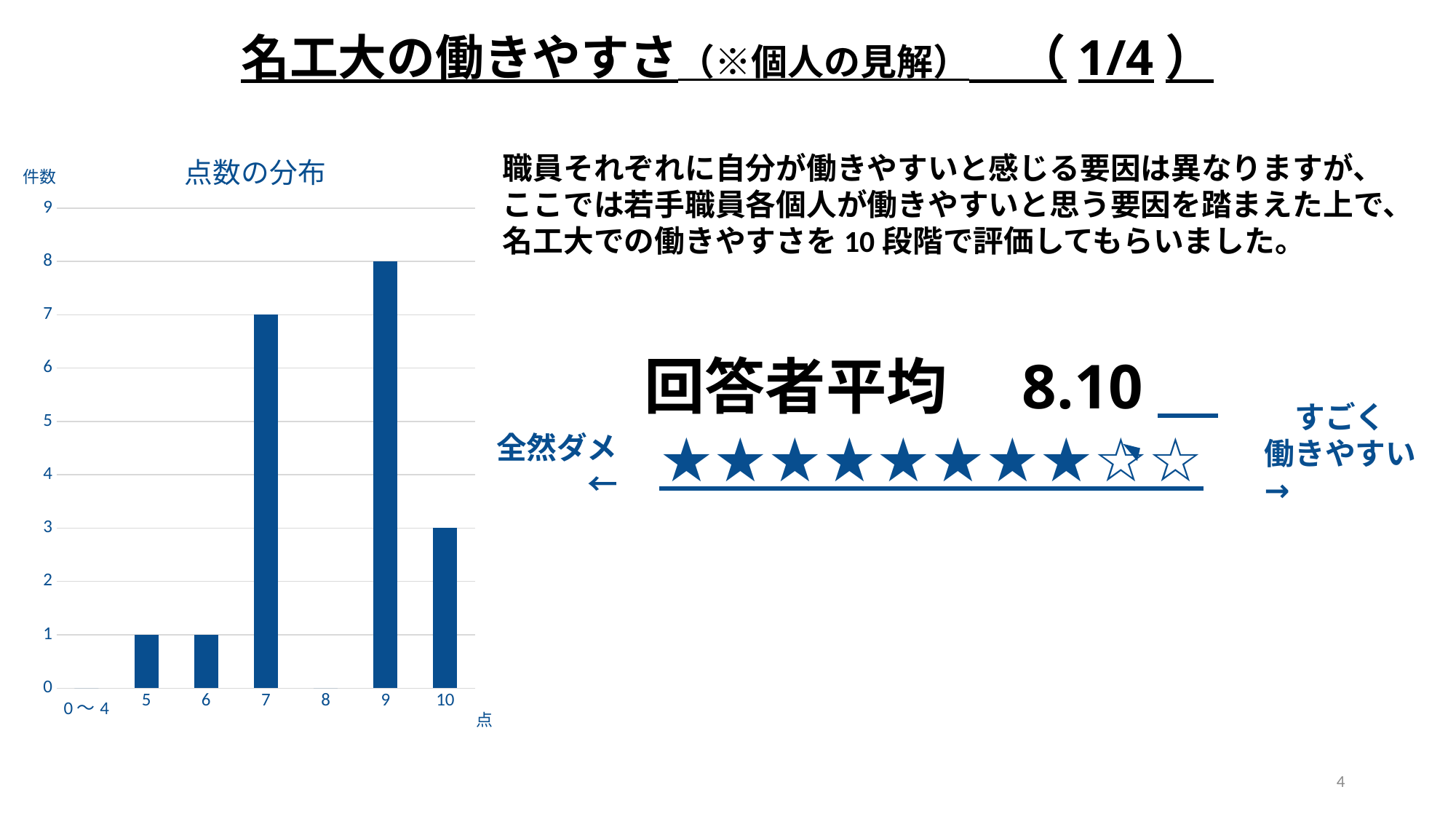
What is the value (件数) for the score 7? 7 What is the title of the chart? 点数の分布 Is the value for score 9 greater or less than 5? greater Which score has the highest count in the chart? 9 What is the value (件数) for the score 10? 3 What is the difference between the counts for score 9 and score 7? 1 What is the value (件数) for the score 9? 8 What is the difference between the counts for score 7 and score 10? 4 What type of chart is shown on the slide? bar chart Which has a larger count, score 10 or score 6? 10 How many categories are shown on the x axis of the chart? 7 What is the value (件数) for the score 5? 1